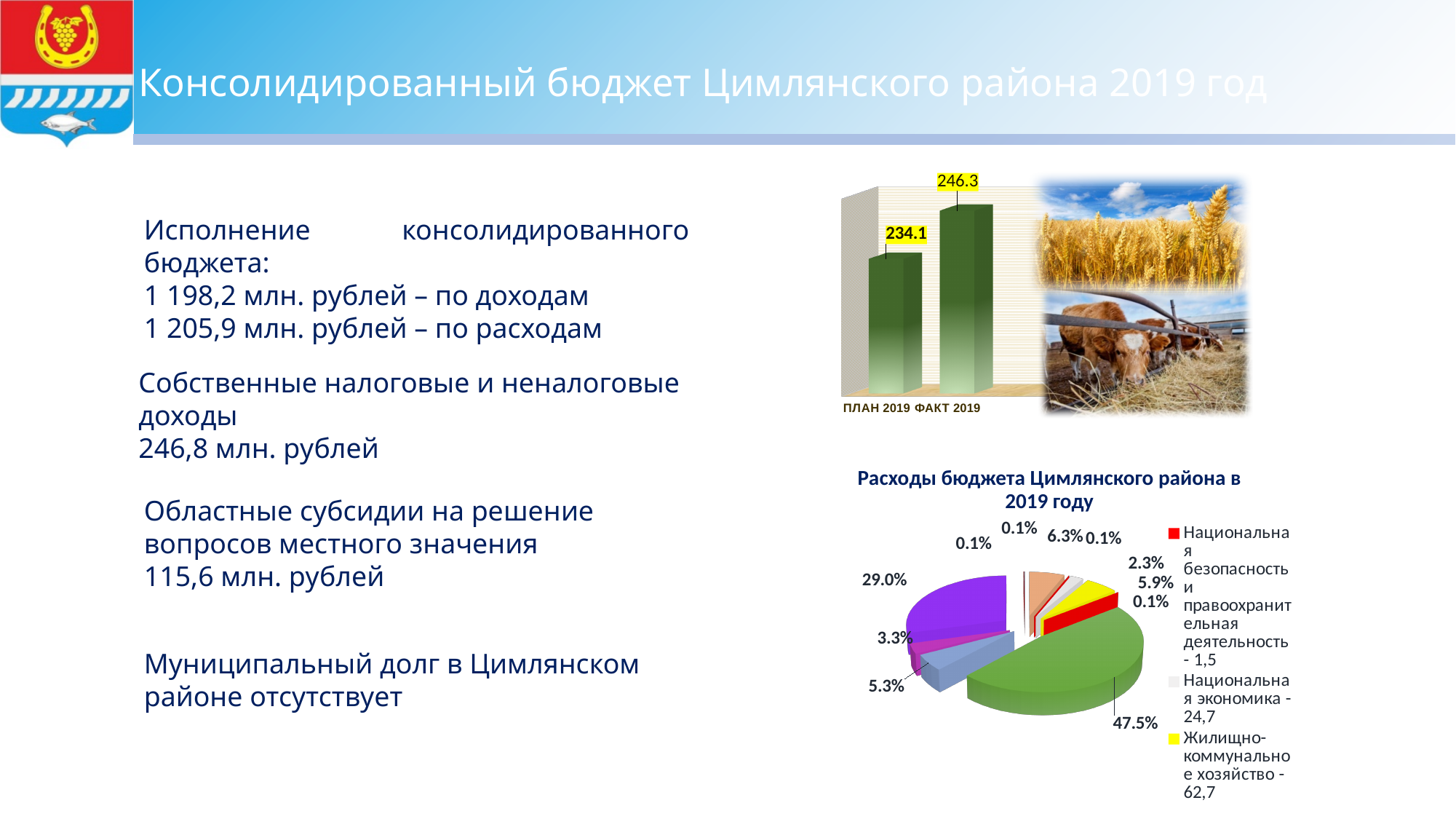
In the pie chart 'Расходы бюджета Цимлянского района в 2019 году', what is the share of the largest slice? 47.5% What kind of chart is the one at the top right with ПЛАН 2019 and ФАКТ 2019? bar chart In the pie chart 'Расходы бюджета Цимлянского района в 2019 году', what value is shown in the legend for Национальная экономика? 24,7 What kind of chart is 'Расходы бюджета Цимлянского района в 2019 году'? pie chart How many bars are in the bar chart at the top right? 2 In the pie chart 'Расходы бюджета Цимлянского района в 2019 году', what is the difference between the largest slice (47.5%) and the purple slice (29.0%)? 18.5% In the bar chart at the top right, what is the value for ПЛАН 2019? 234.1 In the bar chart at the top right, which bar is higher, ПЛАН 2019 or ФАКТ 2019? ФАКТ 2019 In the bar chart at the top right, what is the value for ФАКТ 2019? 246.3 In the pie chart 'Расходы бюджета Цимлянского района в 2019 году', what is the share of the second-largest slice (the purple one)? 29.0% In the pie chart 'Расходы бюджета Цимлянского района в 2019 году', what colour is the legend marker for Жилищно-коммунальное хозяйство? yellow In the bar chart at the top right, what is the difference between ФАКТ 2019 and ПЛАН 2019? 12.2